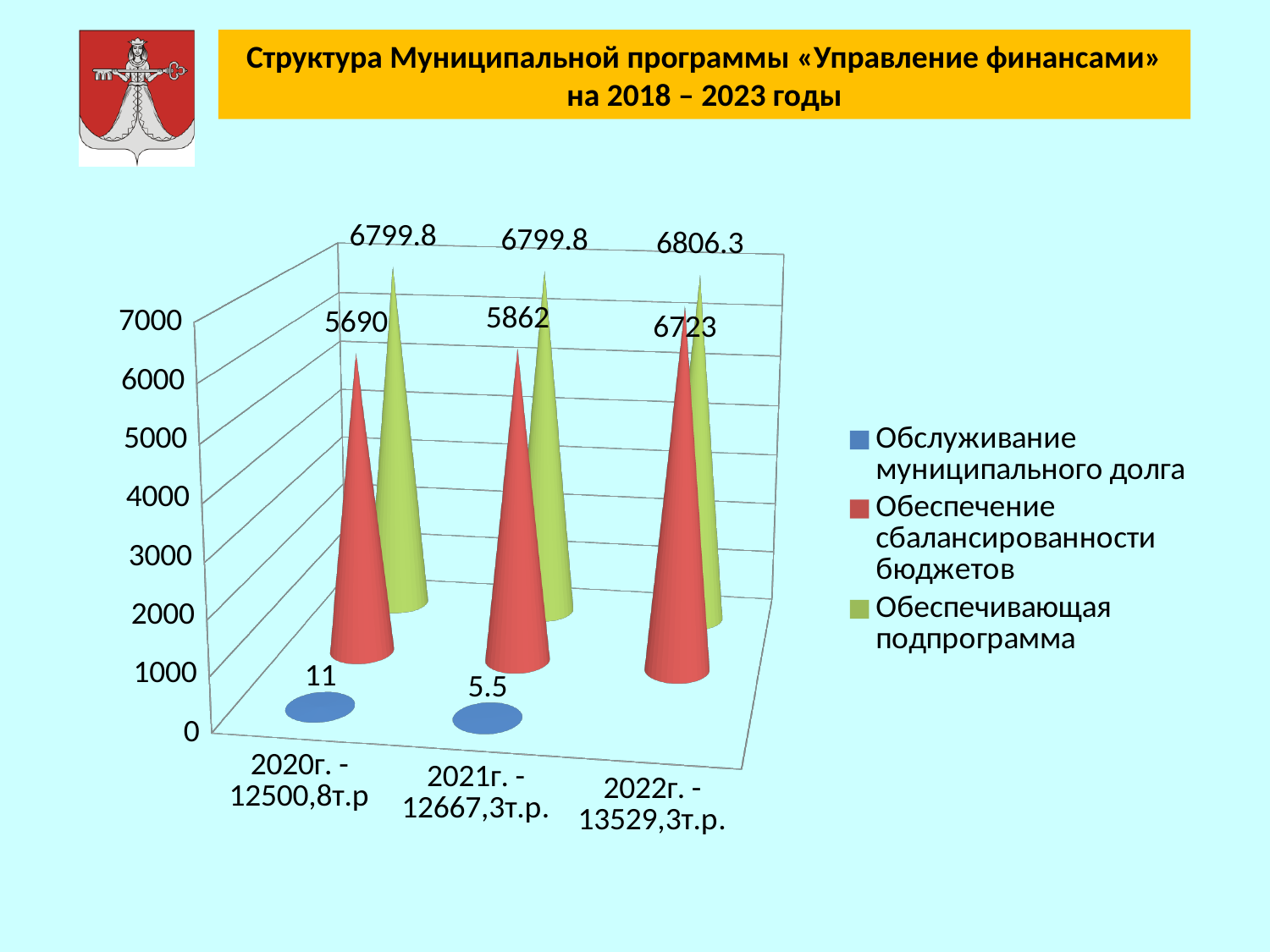
In which year is the value for «Обслуживание муниципального долга» lowest among the years where it is shown? 2021г. Which is larger in 2020г.: «Обеспечение сбалансированности бюджетов» or «Обеспечивающая подпрограмма»? Обеспечивающая подпрограмма What is the difference between the «Обеспечение сбалансированности бюджетов» values for 2022г. and 2021г.? 861 How many series does the legend list? 3 What colour represents «Обеспечивающая подпрограмма» in the chart? green What is the value for «Обеспечение сбалансированности бюджетов» in 2020г.? 5690 What is the value for «Обслуживание муниципального долга» in 2021г.? 5.5 In which year is the value for «Обеспечение сбалансированности бюджетов» highest? 2022г. Does the value for «Обеспечение сбалансированности бюджетов» rise or fall from 2020г. to 2022г.? rise What is the value for «Обеспечение сбалансированности бюджетов» in 2021г.? 5862 What is the value for «Обеспечивающая подпрограмма» in 2022г.? 6806.3 Is the value for «Обеспечение сбалансированности бюджетов» in 2020г. greater or less than 6000? less